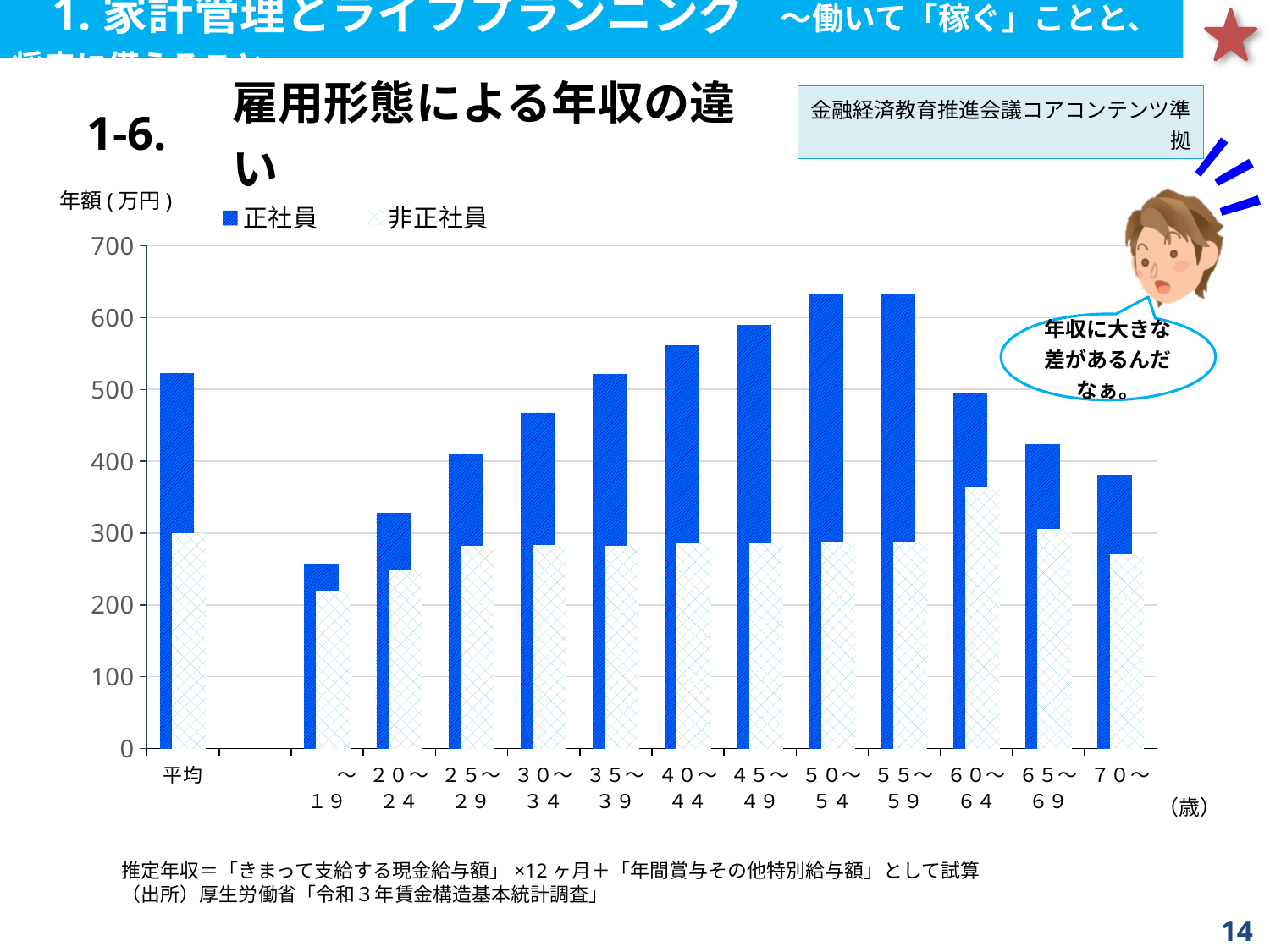
Which category has the highest value for 非正社員? 60～64 In the 40～44 category, which is larger: 正社員 or 非正社員? 正社員 How many categories are shown along the x axis? 13 Is the value for 非正社員 in 60～64 greater or less than 300? greater Is the value for 正社員 in ～19 greater or less than 300? less What is the title of the chart? 雇用形態による年収の違い How many series does the legend list? 2 Is the value for 正社員 in 45～49 greater or less than 500? greater Do the 正社員 values rise or fall from ～19 to 50～54? rise What kind of chart is shown on the slide? bar chart Which category has the lowest value for 正社員? ～19